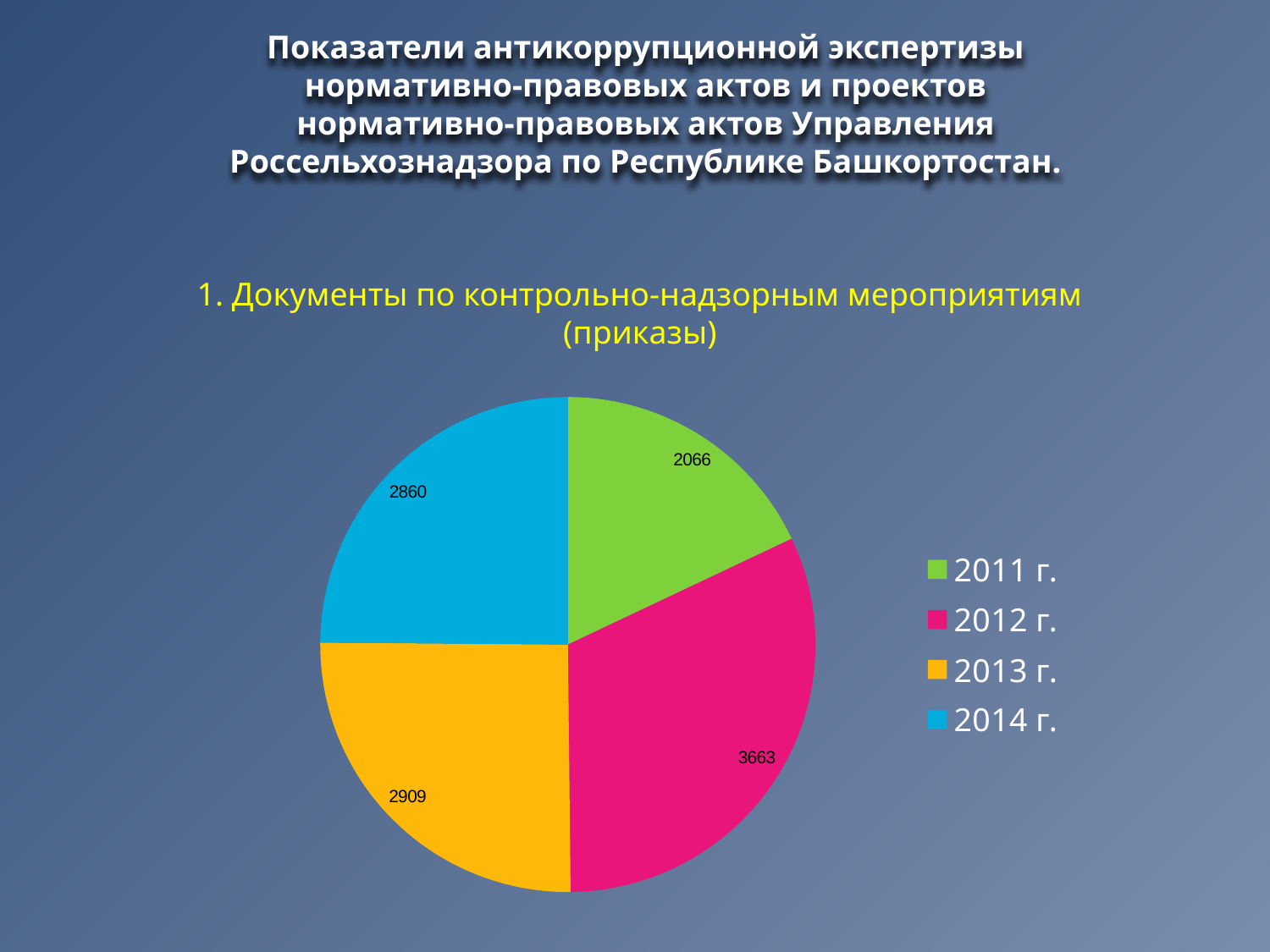
What is the value for 2011 г. in the pie chart? 2066 What is the value for 2014 г. in the pie chart? 2860 What is the difference between the values for 2013 г. and 2014 г.? 49 What is the value for 2012 г. in the pie chart? 3663 What colour is the slice for 2014 г. in the pie chart? Blue What is the difference between the values for 2012 г. and 2011 г.? 1597 What is the value for 2013 г. in the pie chart? 2909 Which year has the largest slice in the pie chart? 2012 г. Which is larger, the value for 2013 г. or the value for 2014 г.? 2013 г. How many slices does the pie chart have? 4 What type of chart is shown on the slide? Pie chart Which year has the smallest slice in the pie chart? 2011 г.